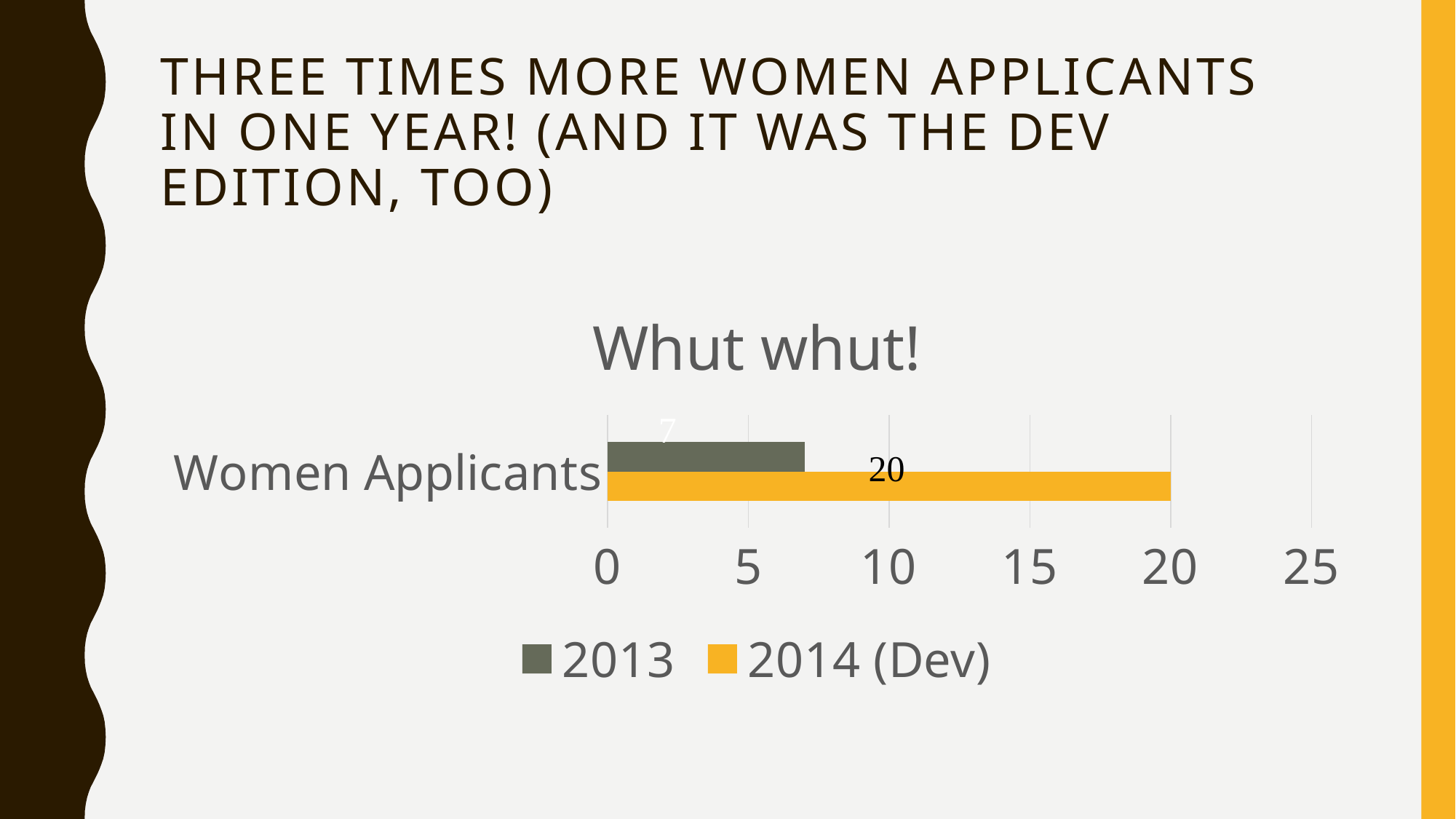
Which series has the higher value for Women Applicants, 2013 or 2014 (Dev)? 2014 (Dev) Which series has the lowest value on the chart? 2013 What is the value for 2014 (Dev) Women Applicants? 20 How many series does the legend list? 2 What kind of chart is shown on the slide? Bar chart How many categories are shown on the chart? 1 Which series is shown in yellow? 2014 (Dev) What is the title of the chart? Whut whut! Is the value for 2014 (Dev) Women Applicants greater or less than 15? greater Is the value for 2013 Women Applicants greater or less than 10? less What is the difference between the 2014 (Dev) and 2013 values for Women Applicants? 13 What is the value for 2013 Women Applicants? 7